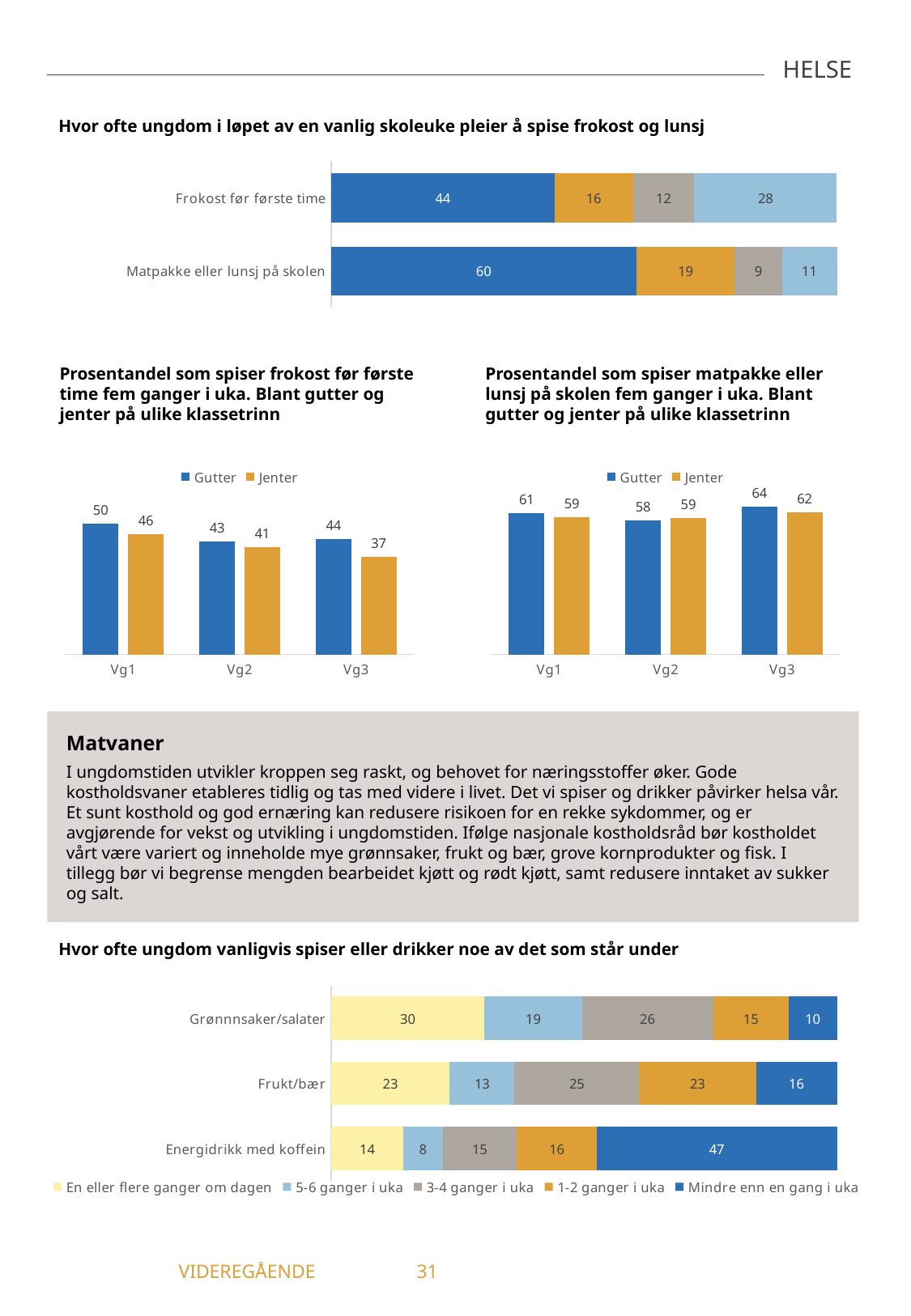
In the chart 'Prosentandel som spiser frokost før første time fem ganger i uka', what is the difference between Gutter and Jenter at Vg3? 7 In the chart 'Hvor ofte ungdom i løpet av en vanlig skoleuke pleier å spise frokost og lunsj', what is the value of the first (dark blue) segment for 'Matpakke eller lunsj på skolen'? 60 In the chart 'Prosentandel som spiser matpakke eller lunsj på skolen fem ganger i uka', which is larger at Vg2: Gutter or Jenter? Jenter In the chart 'Prosentandel som spiser frokost før første time fem ganger i uka', which class level has the highest value for Gutter? Vg1 In the chart 'Prosentandel som spiser frokost før første time fem ganger i uka', what is the value for Jenter at Vg3? 37 In the chart 'Hvor ofte ungdom vanligvis spiser eller drikker noe av det som står under', what is the value for 'Mindre enn en gang i uka' for 'Energidrikk med koffein'? 47 In the chart 'Hvor ofte ungdom vanligvis spiser eller drikker noe av det som står under', which category has the highest value for 'En eller flere ganger om dagen'? Grønnnsaker/salater In the chart 'Prosentandel som spiser matpakke eller lunsj på skolen fem ganger i uka', what is the value for Gutter at Vg3? 64 In the chart 'Hvor ofte ungdom i løpet av en vanlig skoleuke pleier å spise frokost og lunsj', what is the total of the stacked bar for 'Frokost før første time'? 100 How many series does the legend list in the chart 'Prosentandel som spiser matpakke eller lunsj på skolen fem ganger i uka'? 2 What kind of chart is 'Hvor ofte ungdom vanligvis spiser eller drikker noe av det som står under'? Stacked bar chart How many categories are shown in the chart 'Hvor ofte ungdom vanligvis spiser eller drikker noe av det som står under'? 3